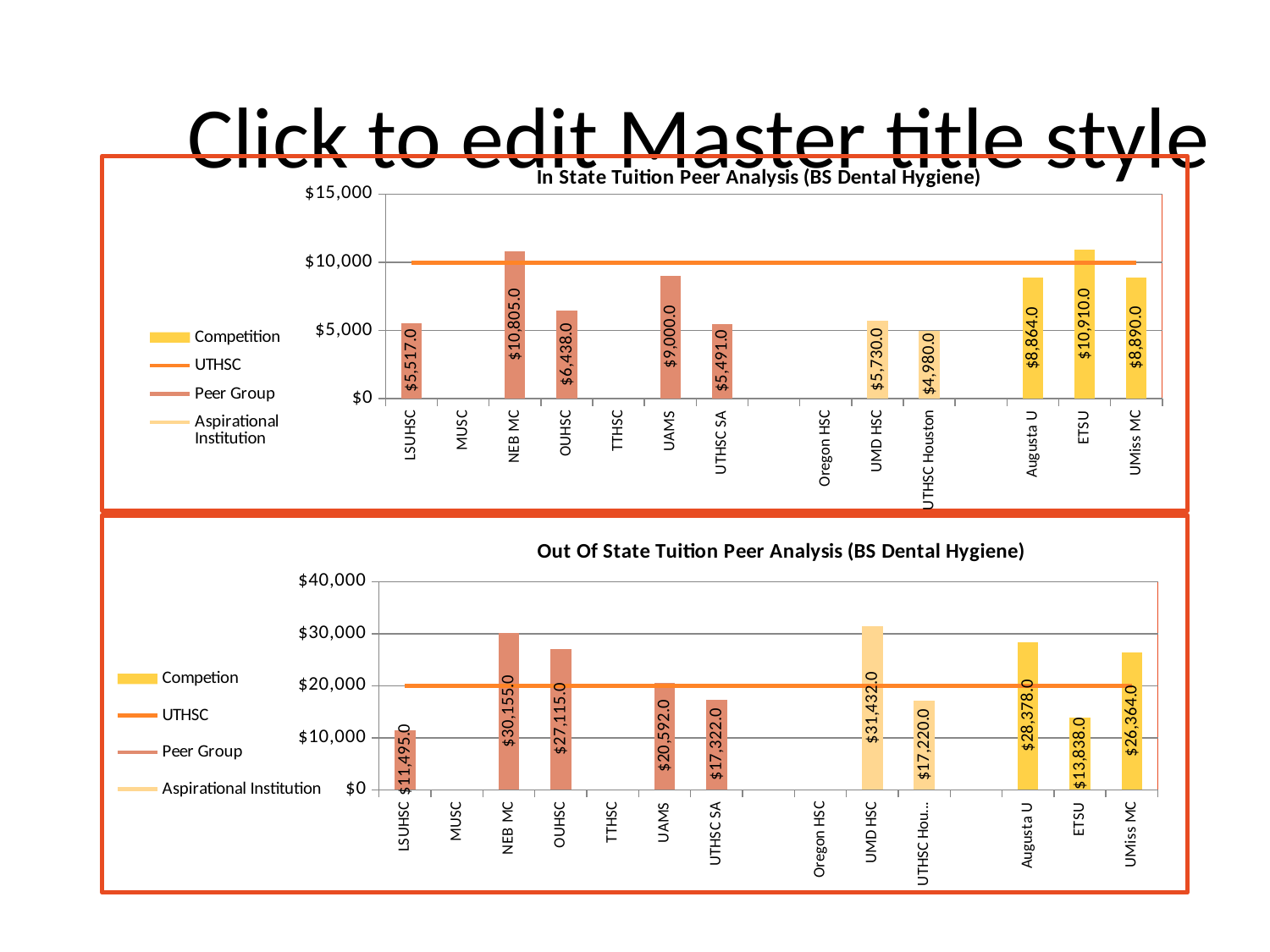
In the In State Tuition Peer Analysis chart, what is the difference between ETSU and NEB MC? $105.0 In the Out Of State Tuition Peer Analysis chart, what is the value for UMD HSC? $31,432.0 In the Out Of State Tuition Peer Analysis chart, which institution has the lowest tuition? LSUHSC In the Out Of State Tuition Peer Analysis chart, which is larger, Augusta U or OUHSC? Augusta U In the In State Tuition Peer Analysis chart, what is the value for NEB MC? $10,805.0 In the In State Tuition Peer Analysis chart, which institution has the highest tuition? ETSU In the In State Tuition Peer Analysis chart, is the value for UAMS greater or less than $5,000? greater In the In State Tuition Peer Analysis chart, which institution has the lowest tuition? UTHSC Houston What type of chart is the In State Tuition Peer Analysis chart? Bar chart How many institutions are labelled on the x axis of the Out Of State Tuition Peer Analysis chart? 13 How many entries does the legend of the Out Of State Tuition Peer Analysis chart list? 4 In the Out Of State Tuition Peer Analysis chart, what is the difference between NEB MC and OUHSC? $3,040.0